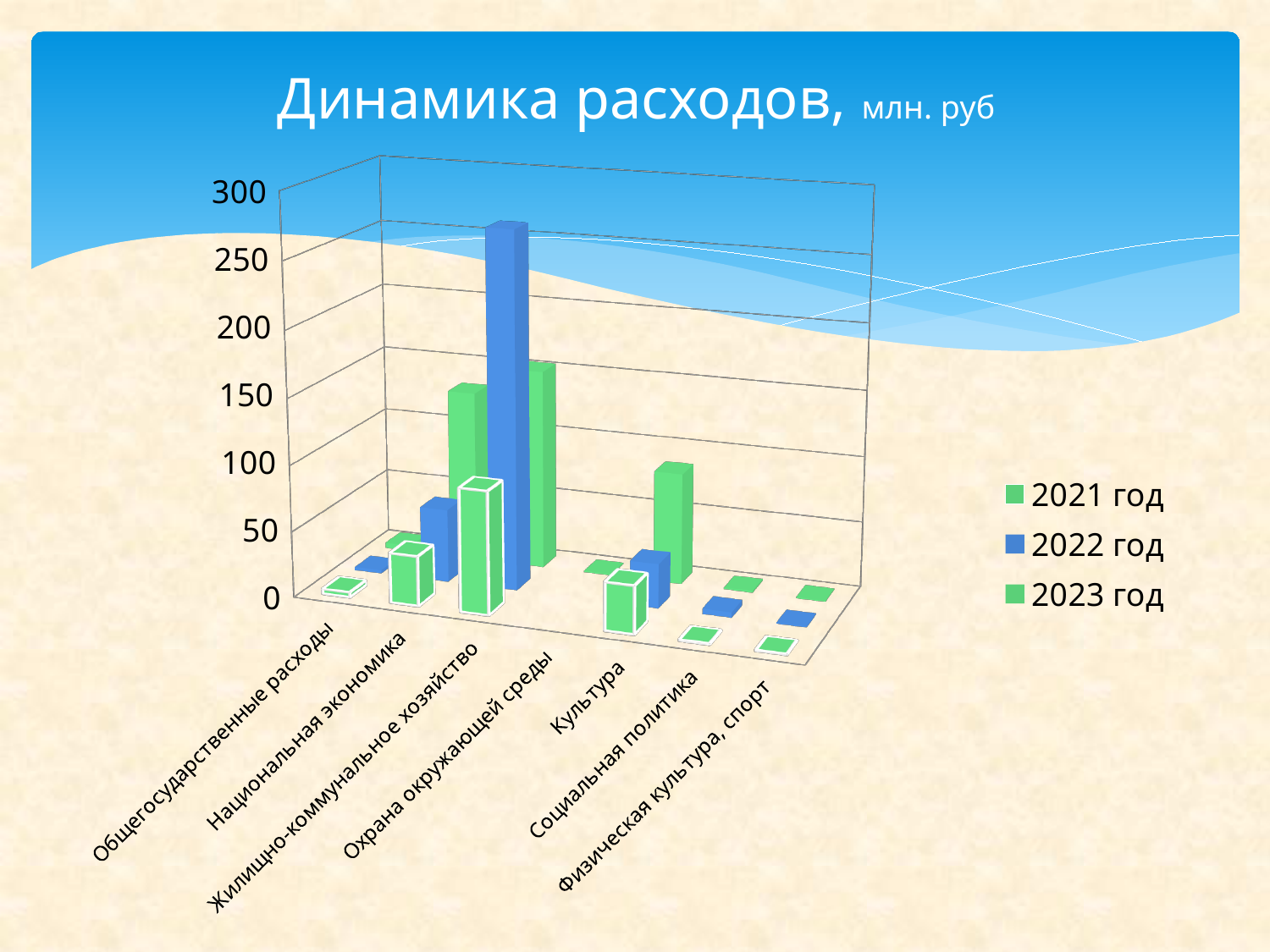
Is the 2022 год value for Общегосударственные расходы greater or less than 50? less What kind of chart is shown on the slide? Bar chart How many series does the legend list? 3 Which years are listed in the legend? 2021 год, 2022 год, 2023 год How many expenditure categories are shown on the x axis? 7 Is the 2022 год value for Жилищно-коммунальное хозяйство greater or less than 200? greater Which category has the tallest bar in the whole chart? Жилищно-коммунальное хозяйство In the 2022 год series, which is larger: Национальная экономика or Социальная политика? Национальная экономика What is the title of the chart? Динамика расходов, млн. руб In the 2022 год series, which is larger: Жилищно-коммунальное хозяйство or Национальная экономика? Жилищно-коммунальное хозяйство Is the 2022 год value for Культура greater or less than 100? less For the 2022 год series, which category has the highest value? Жилищно-коммунальное хозяйство